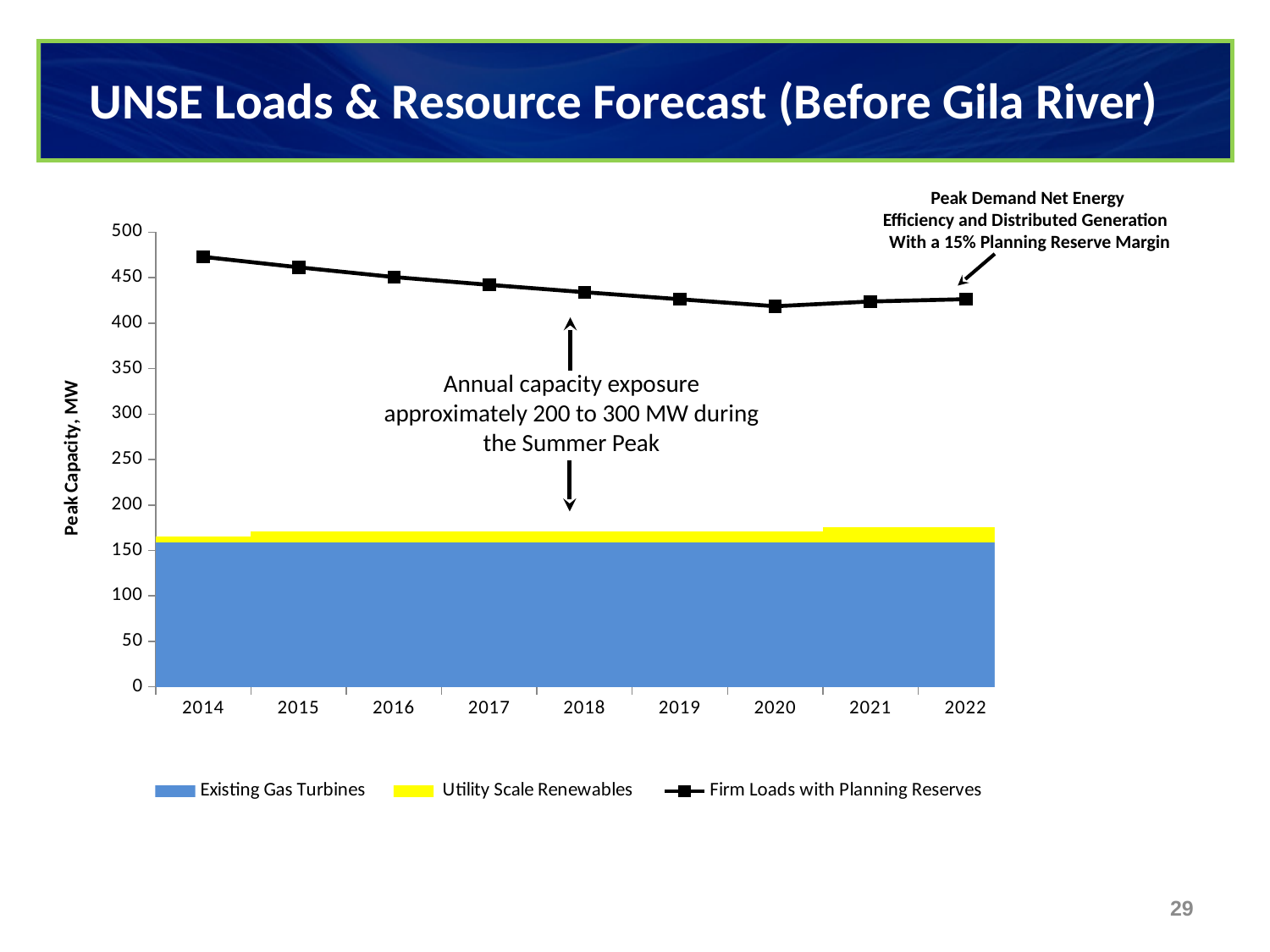
Is the Firm Loads with Planning Reserves value for 2020 greater or less than 450? less Does the Firm Loads with Planning Reserves line rise or fall from 2014 to 2020? fall How many years are shown on the x axis of the chart? 9 What is the title of the vertical axis? Peak Capacity, MW In which year is the Firm Loads with Planning Reserves value lowest? 2020 Is the Firm Loads with Planning Reserves value for 2014 greater or less than 450? greater In which year is the Firm Loads with Planning Reserves value highest? 2014 Is the Firm Loads with Planning Reserves value for 2020 greater or less than 400? greater Which is larger in 2016, the Firm Loads with Planning Reserves value or the Existing Gas Turbines value? Firm Loads with Planning Reserves How many series does the chart legend list? 3 What kind of chart is shown on the slide? Combination of a stacked bar chart and a line chart